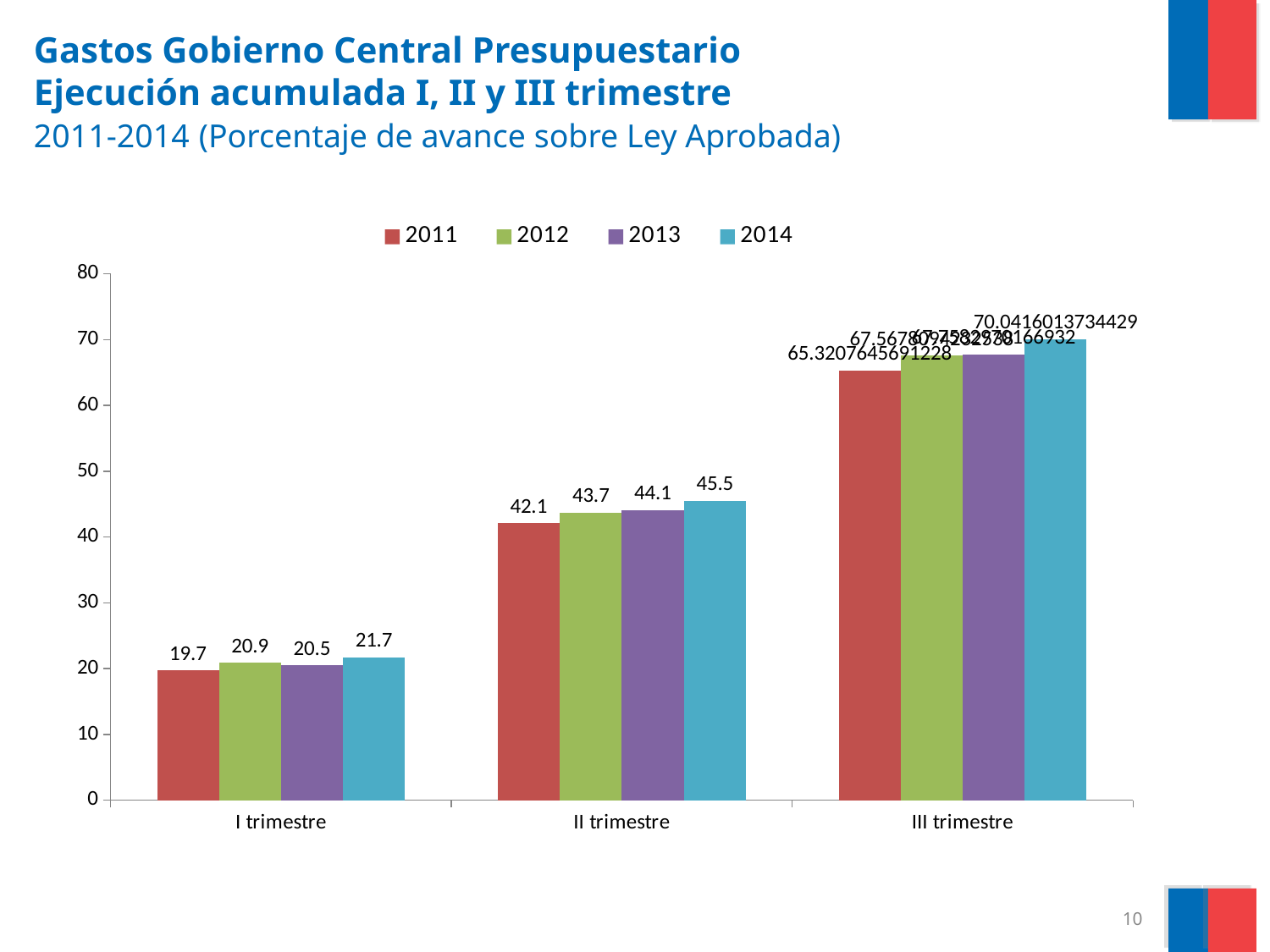
How many series does the legend list? 4 Which year has the lowest value in II trimestre? 2011 Which year has the highest value in I trimestre? 2014 What is the value for 2013 in II trimestre? 44.1 What type of chart is shown on the slide? bar chart Which is larger in I trimestre, the value for 2012 or the value for 2013? 2012 Do the values for 2014 rise or fall from I trimestre to III trimestre? rise What is the value for 2014 in II trimestre? 45.5 What is the value for 2011 in I trimestre? 19.7 What is the difference between the 2014 and 2011 values in II trimestre? 3.4 How many categories are shown on the x axis? 3 Is the value for 2011 in III trimestre greater or less than 60? greater